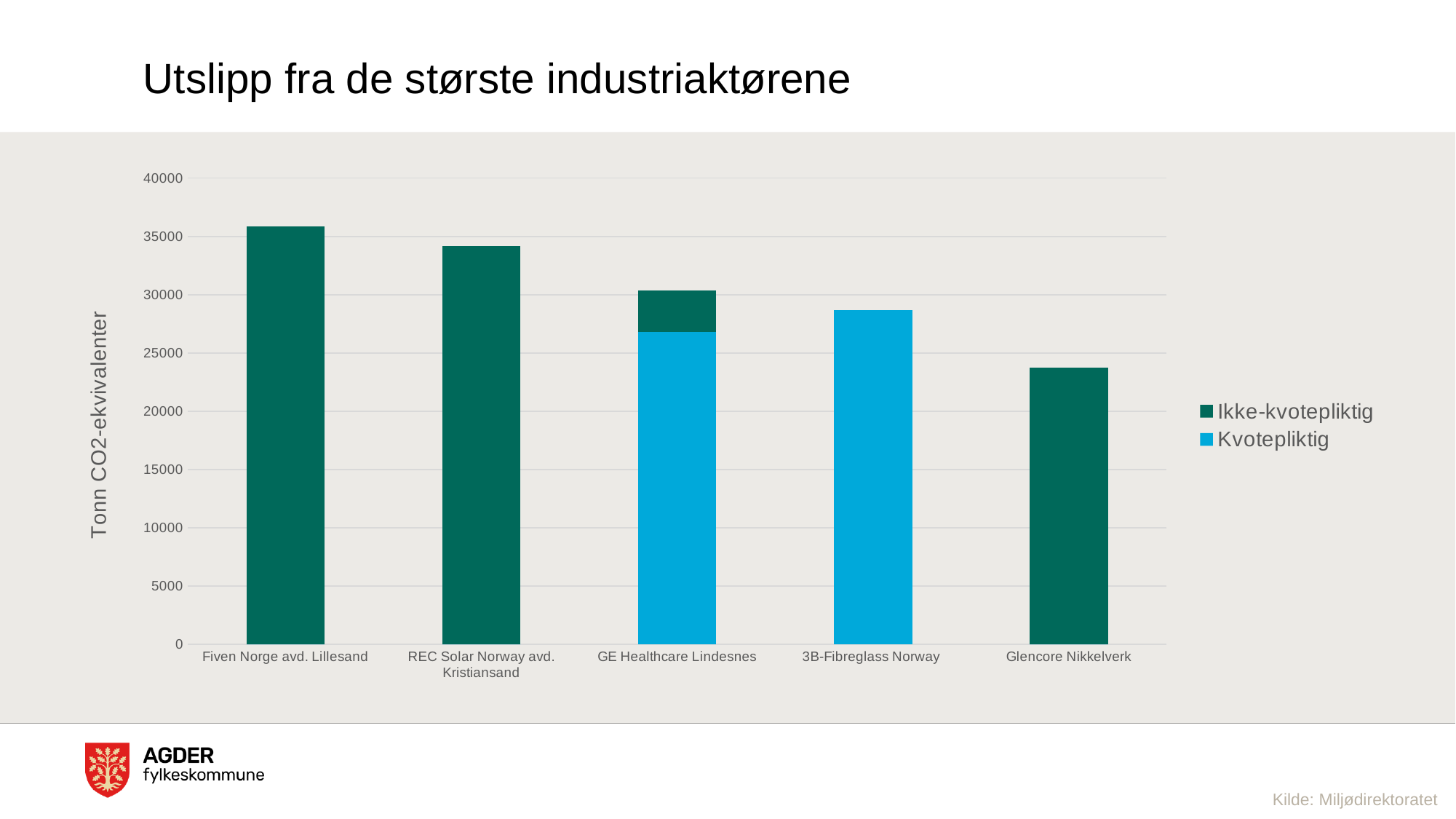
What is the label on the vertical axis? Tonn CO2-ekvivalenter Is the total value for 3B-Fibreglass Norway greater or less than 30000? less How many industrial actors (categories) are shown on the x axis? 5 Which industrial actor has the highest total emissions? Fiven Norge avd. Lillesand How many series does the legend list? 2 Which industrial actor has the lowest total emissions? Glencore Nikkelverk Do the total emissions rise or fall from left to right across the categories? fall Which has higher total emissions, REC Solar Norway avd. Kristiansand or GE Healthcare Lindesnes? REC Solar Norway avd. Kristiansand Is the total value for Glencore Nikkelverk greater or less than 25000? less Which series is shown in light blue in the legend? Kvotepliktig Is the total value for Fiven Norge avd. Lillesand greater or less than 35000? greater What kind of chart is shown on the slide? bar chart